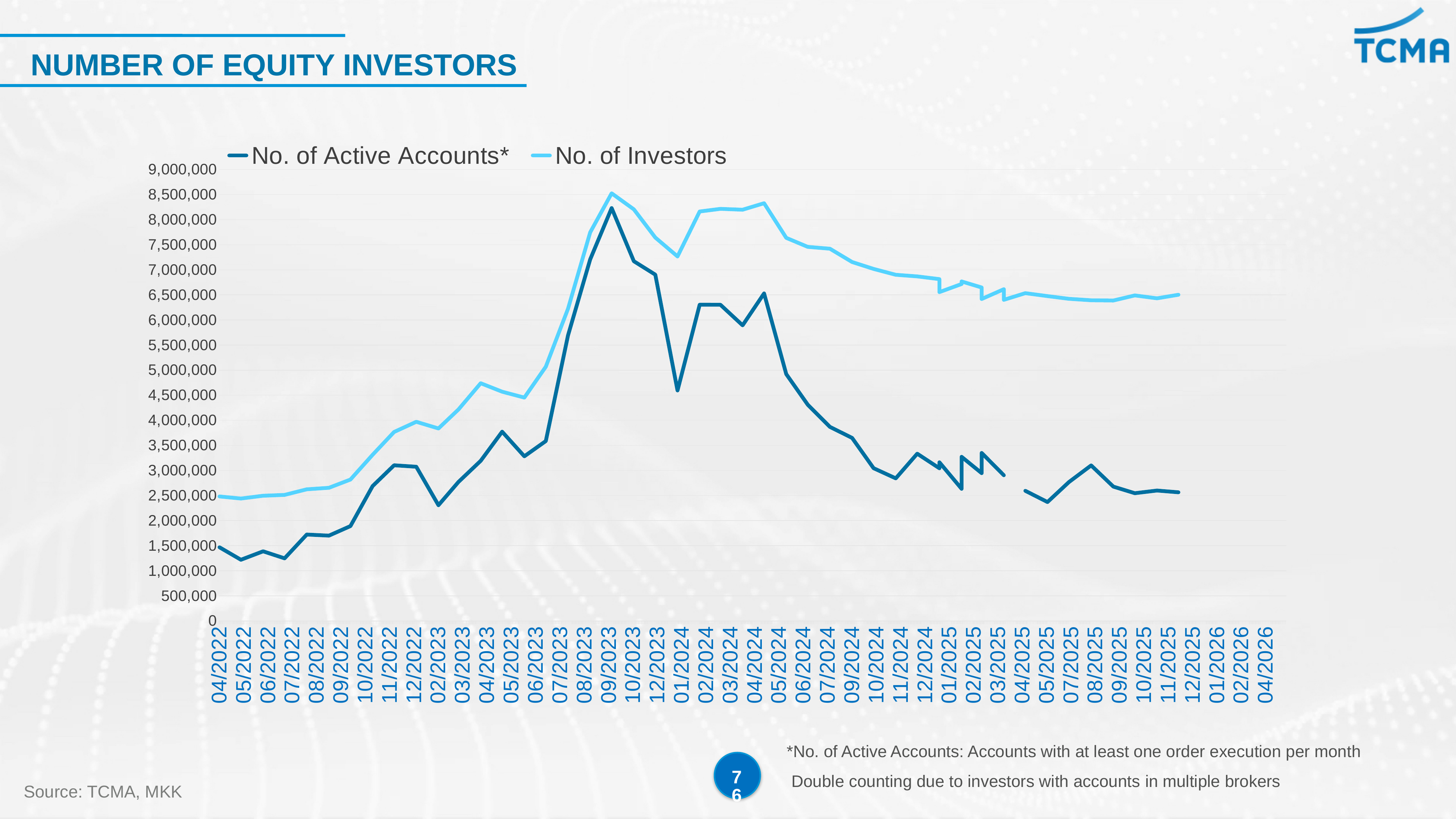
How many series does the legend list? 2 Is the value of No. of Active Accounts* in 11/2025 greater or less than 3,000,000? less What kind of chart is shown on the slide? Line chart Does the No. of Investors series rise or fall between 04/2024 and 11/2025? Fall What is the title of the chart? NUMBER OF EQUITY INVESTORS Is the value of No. of Investors in 11/2025 greater or less than 6,000,000? greater What are the two series named in the legend? No. of Active Accounts* and No. of Investors In 09/2024, which series has the higher value, No. of Active Accounts* or No. of Investors? No. of Investors Is the value of No. of Active Accounts* in 04/2022 greater or less than 2,000,000? less